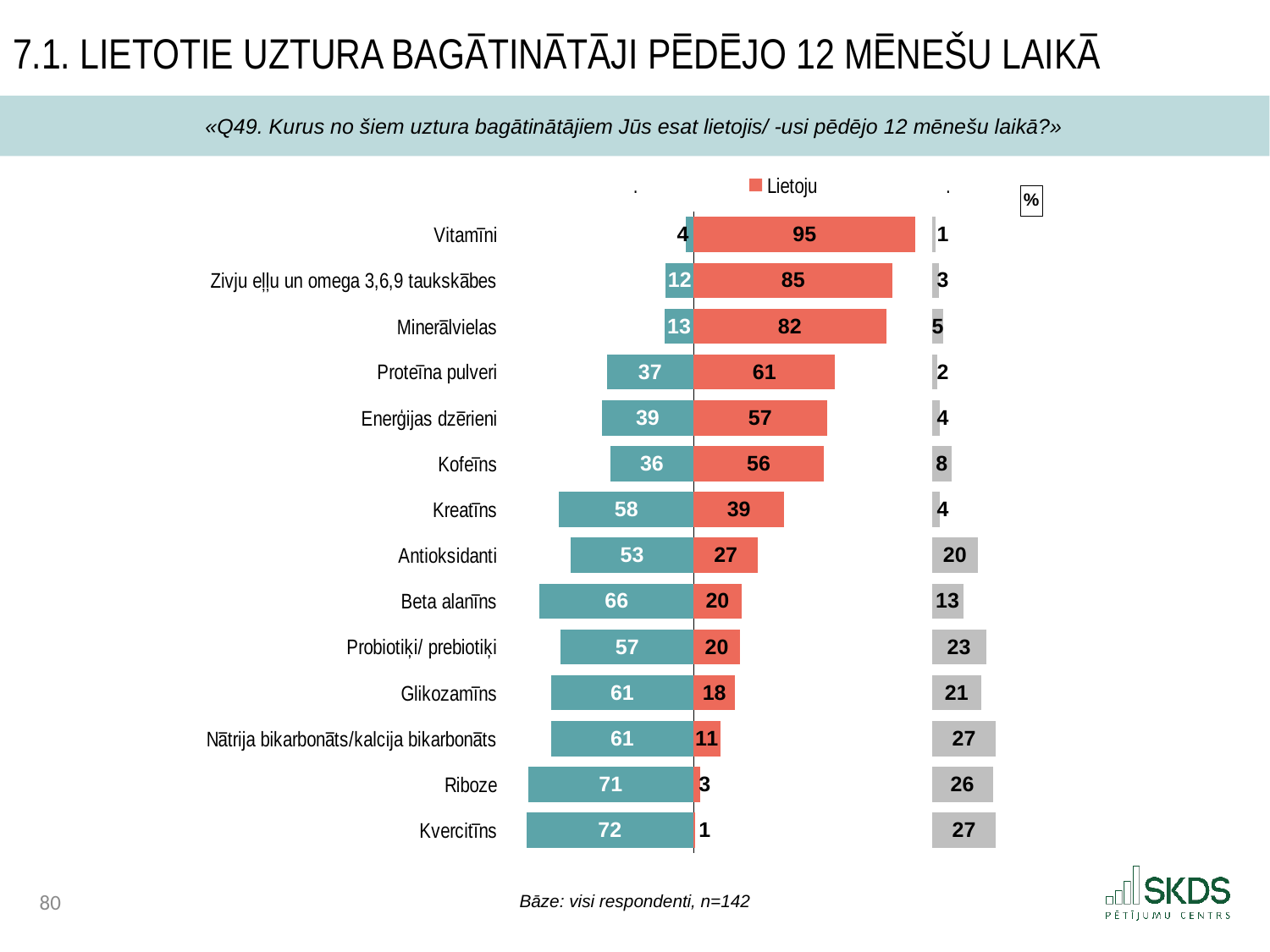
Do the "Lietoju" values rise or fall going from the top category to the bottom category? fall How many series does the legend list? 1 Which category has the highest "Lietoju" value? Vitamīni What kind of chart is shown on the slide? bar chart What is the difference between the "Lietoju" values for Zivju eļļu un omega 3,6,9 taukskābes and Minerālvielas? 3 What is the "Lietoju" value for Nātrija bikarbonāts/kalcija bikarbonāts? 11 What is the "Lietoju" value for Vitamīni? 95 Which category has the lowest "Lietoju" value? Kvercitīns How many categories are shown in the chart? 14 What is the value of the teal bar for Kvercitīns? 72 Which has a larger "Lietoju" value, Proteīna pulveri or Kofeīns? Proteīna pulveri What is the "Lietoju" value for Kreatīns? 39